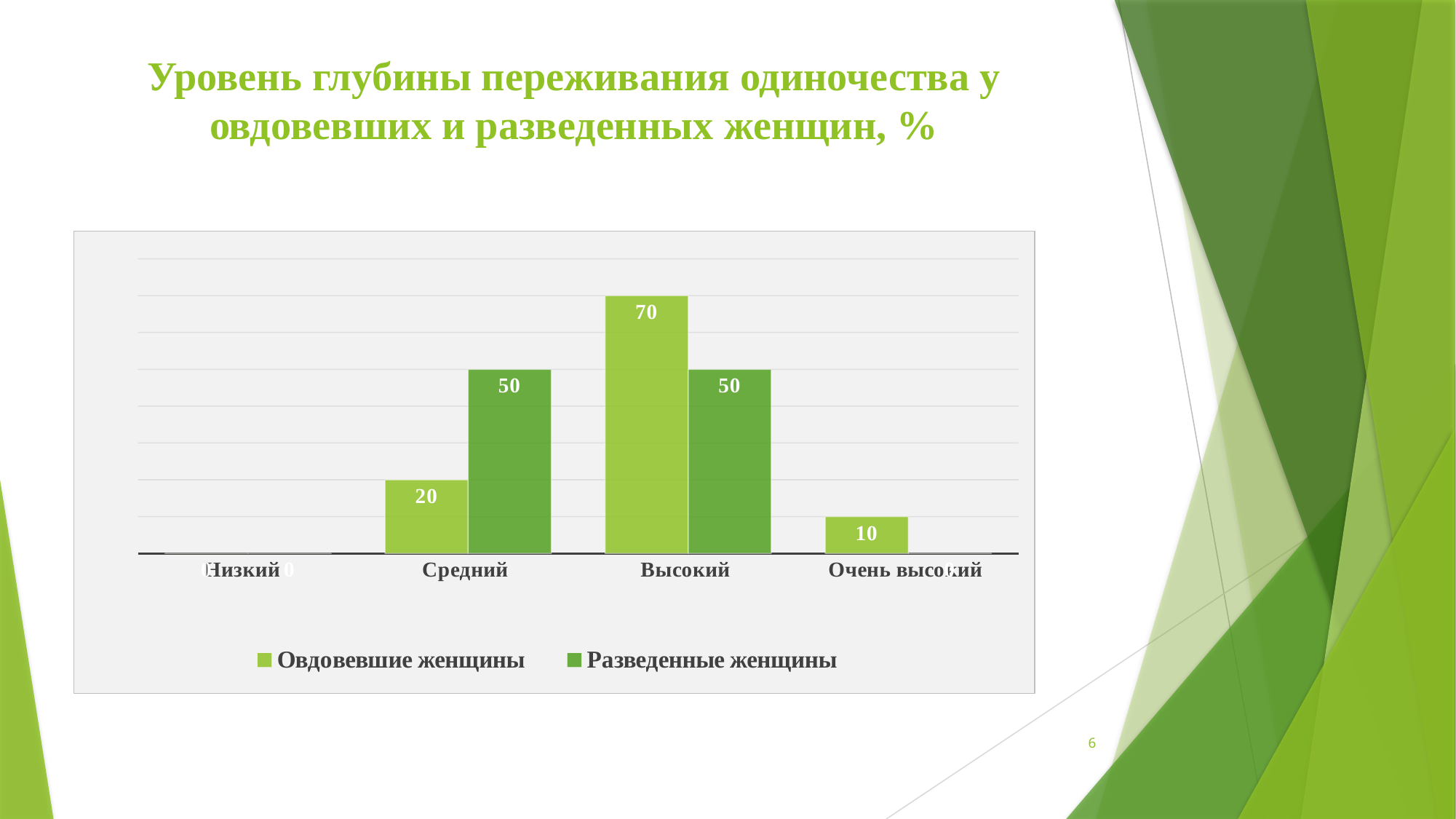
What is the title of the slide? Уровень глубины переживания одиночества у овдовевших и разведенных женщин, % What is the value for Овдовевшие женщины in the Высокий category? 70 Which category has the highest value for Овдовевшие женщины? Высокий What type of chart is shown on the slide? bar chart What is the value for Разведенные женщины in the Средний category? 50 What is the difference between the Овдовевшие женщины and Разведенные женщины values in the Высокий category? 20 How many categories are shown on the x axis? 4 In the Средний category, which series has the larger value: Овдовевшие женщины or Разведенные женщины? Разведенные женщины What is the value for Овдовевшие женщины in the Средний category? 20 What is the value for Разведенные женщины in the Высокий category? 50 What is the value for Овдовевшие женщины in the Очень высокий category? 10 How many series does the legend list? 2